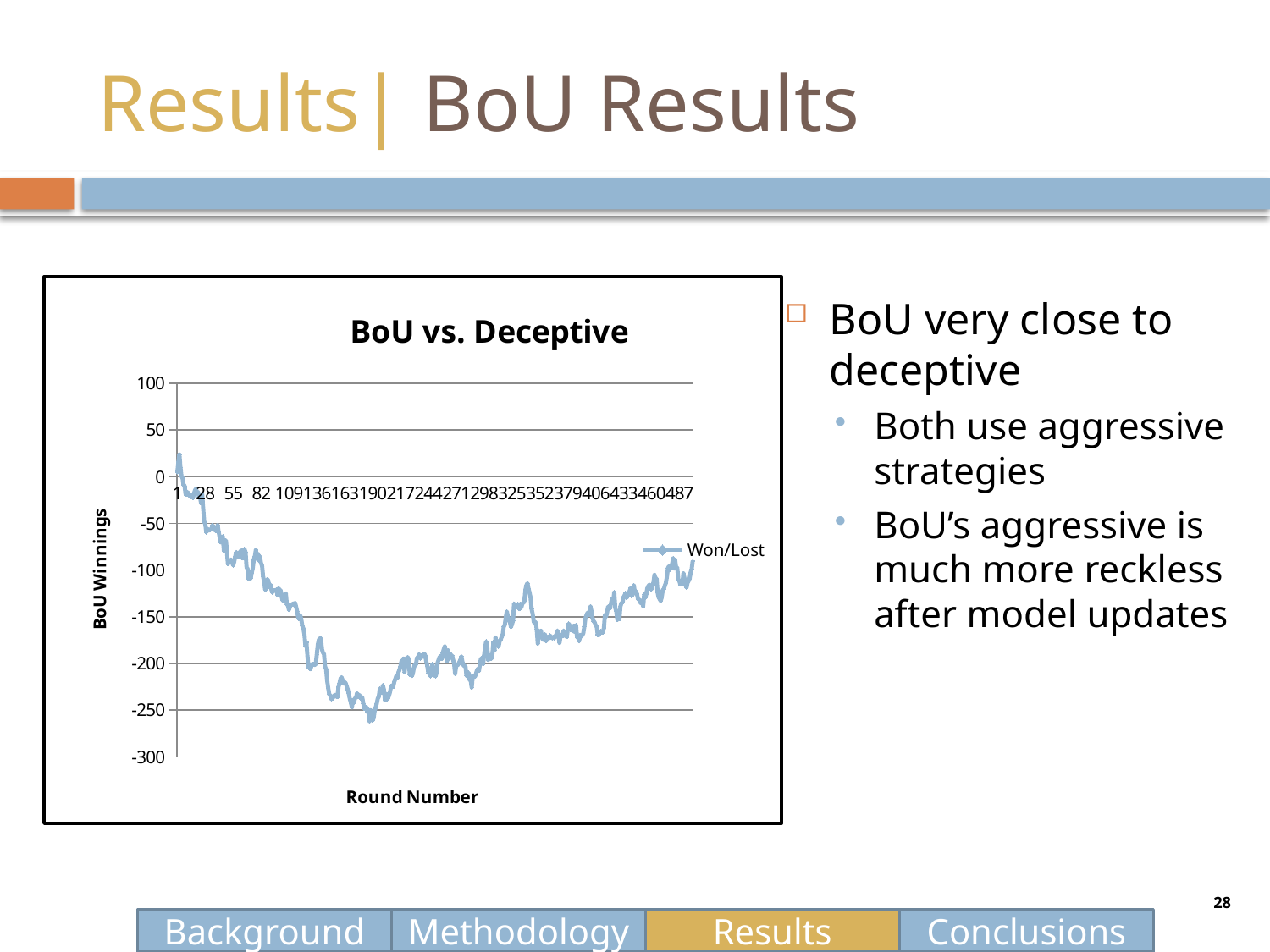
What is the label of the y axis? BoU Winnings What is the title of the chart? BoU vs. Deceptive Is the lowest point of the Won/Lost line greater or less than -200? less How many series does the legend list? 1 What is the highest value shown on the y axis? 100 What is the lowest value shown on the y axis? -300 Is the Won/Lost value at round 487 greater or less than -150? greater Does the Won/Lost line rise or fall between round 1 and round 109? fall What kind of chart is shown on the slide? line chart What is the label of the x axis? Round Number What is the name of the series shown in the legend? Won/Lost